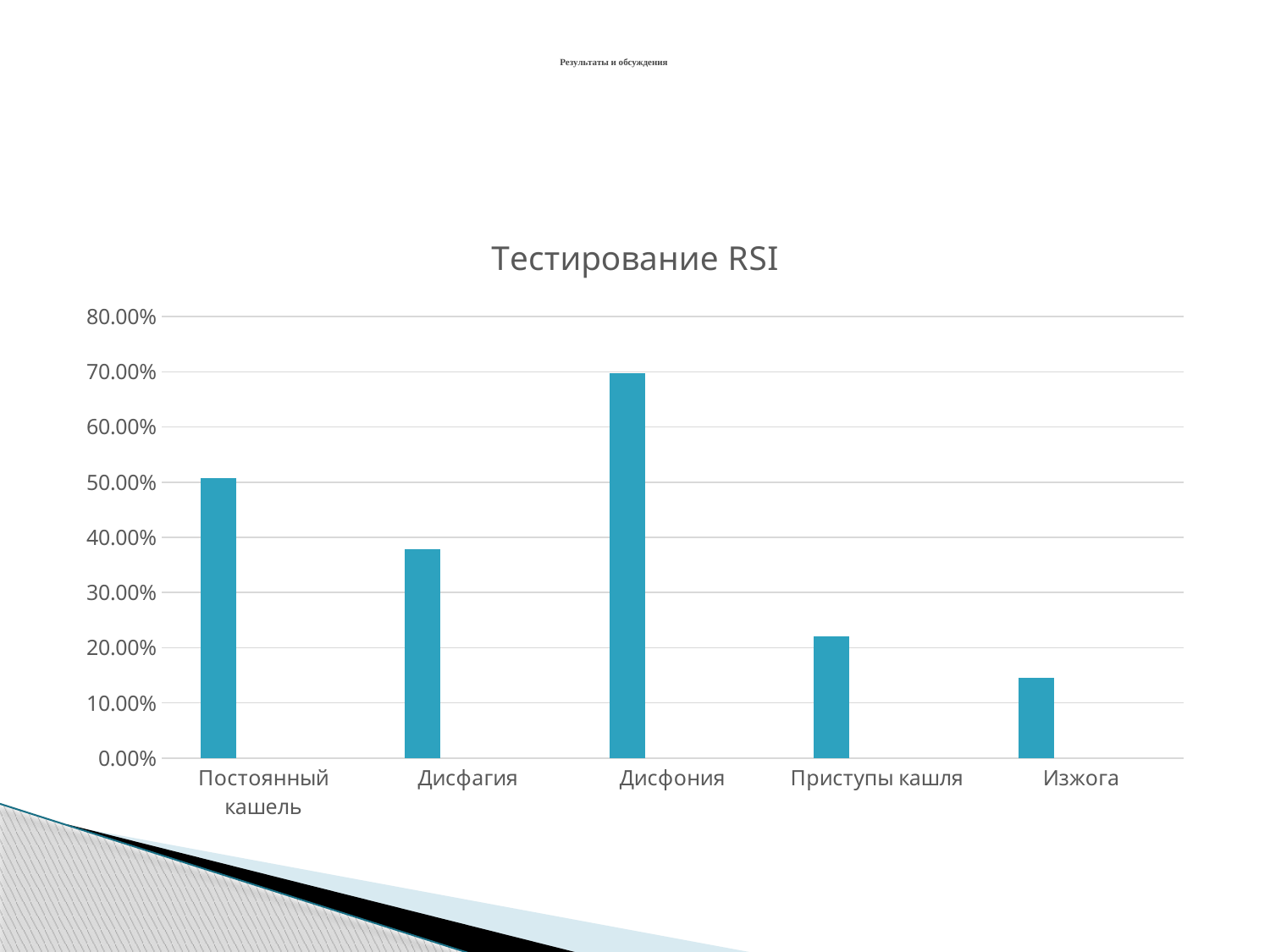
What kind of chart is shown on the slide? bar chart Which category has the highest value in the chart? Дисфония Is the value for Дисфония greater or less than 60.00%? greater Is the value for Дисфагия greater or less than 40.00%? less Which is larger, the value for Приступы кашля or the value for Изжога? Приступы кашля What is the title of the chart? Тестирование RSI Is the value for Приступы кашля greater or less than 20.00%? greater Which is larger, the value for Постоянный кашель or the value for Дисфагия? Постоянный кашель Which category has the lowest value in the chart? Изжога How many categories are shown on the x axis of the chart? 5